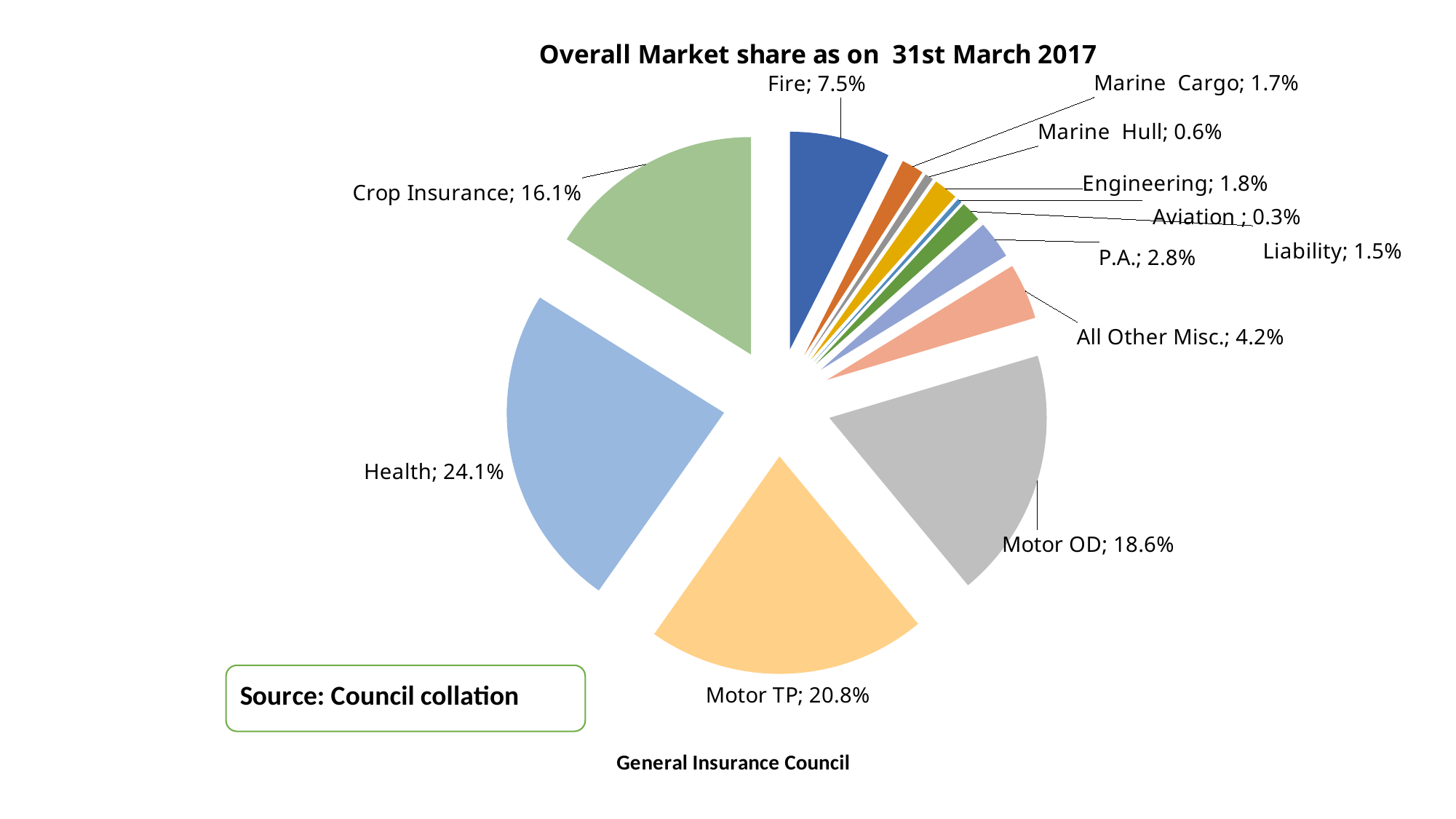
What type of chart is shown on the slide? Pie chart What is the source given for the chart data? Council collation Which category has the largest market share? Health What is the title of the chart? Overall Market share as on 31st March 2017 Which has a larger market share, Fire or All Other Misc.? Fire What is the market share of Health? 24.1% What is the market share of Motor TP? 20.8% What is the difference in market share between Motor TP and Motor OD? 2.2% Which category has the smallest market share? Aviation How many categories are shown in the pie chart? 12 What is the market share of Aviation? 0.3% What is the market share of Crop Insurance? 16.1%